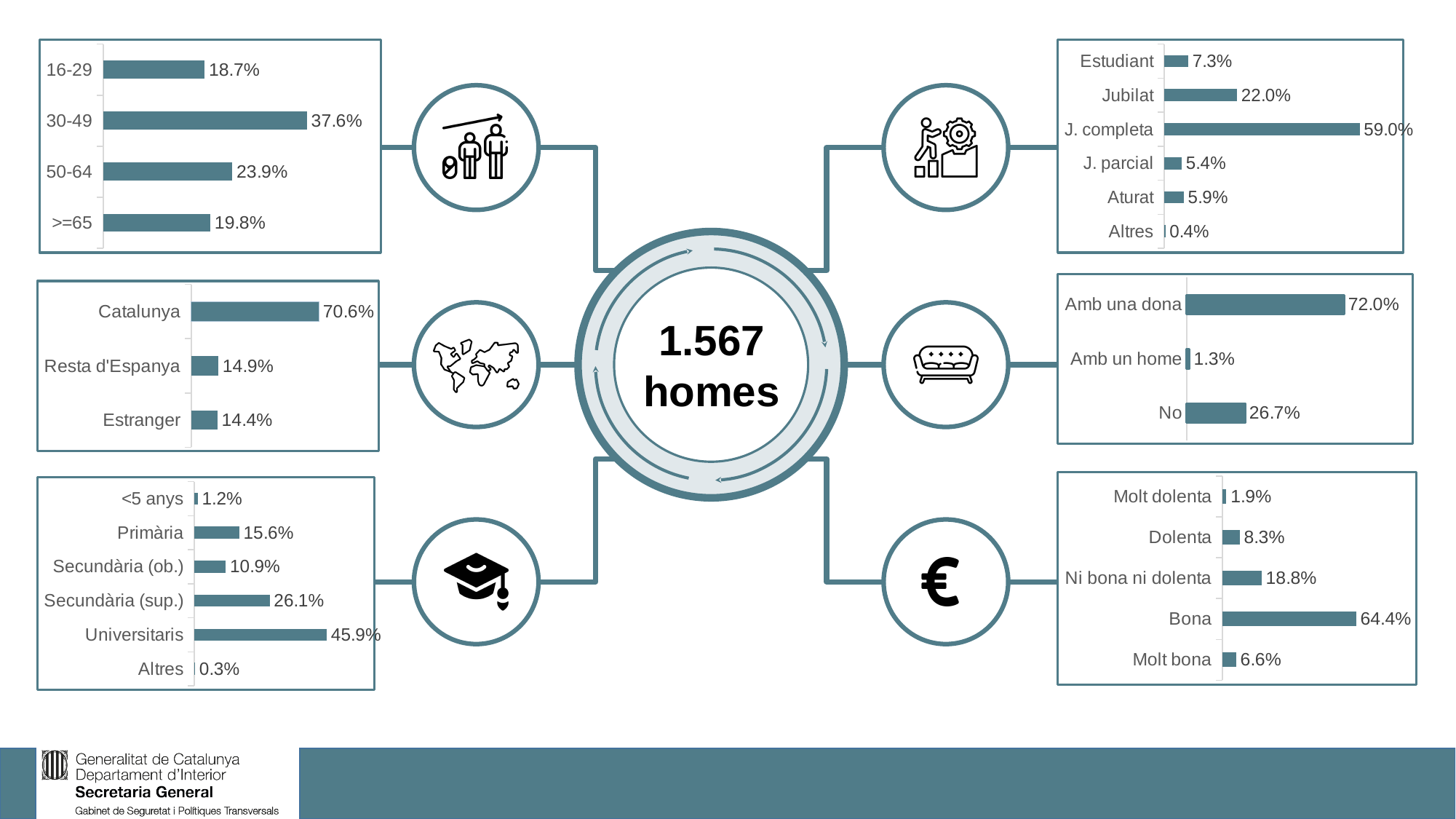
In the middle-left chart, what is the difference between Resta d'Espanya and Estranger? 0.5% In the middle-right chart (Amb una dona, Amb un home, No), what is the value for No? 26.7% What type of chart is the top-left chart (age groups)? Bar chart In the top-left chart (age groups), which category has the lowest value? 16-29 In the top-right chart (employment status), what is the value for Jubilat? 22.0% In the middle-left chart (Catalunya, Resta d'Espanya, Estranger), what is the value for Catalunya? 70.6% In the bottom-left chart (education levels), which category has the highest value? Universitaris In the bottom-right chart (economic situation), which category has the lowest value? Molt dolenta In the top-right chart (employment status), which is larger, J. parcial or Aturat? Aturat In the top-left chart (age groups), what is the value for 30-49? 37.6% How many categories are shown in the bottom-left chart (education levels)? 6 In the bottom-right chart (economic situation), what is the difference between Bona and Ni bona ni dolenta? 45.6%